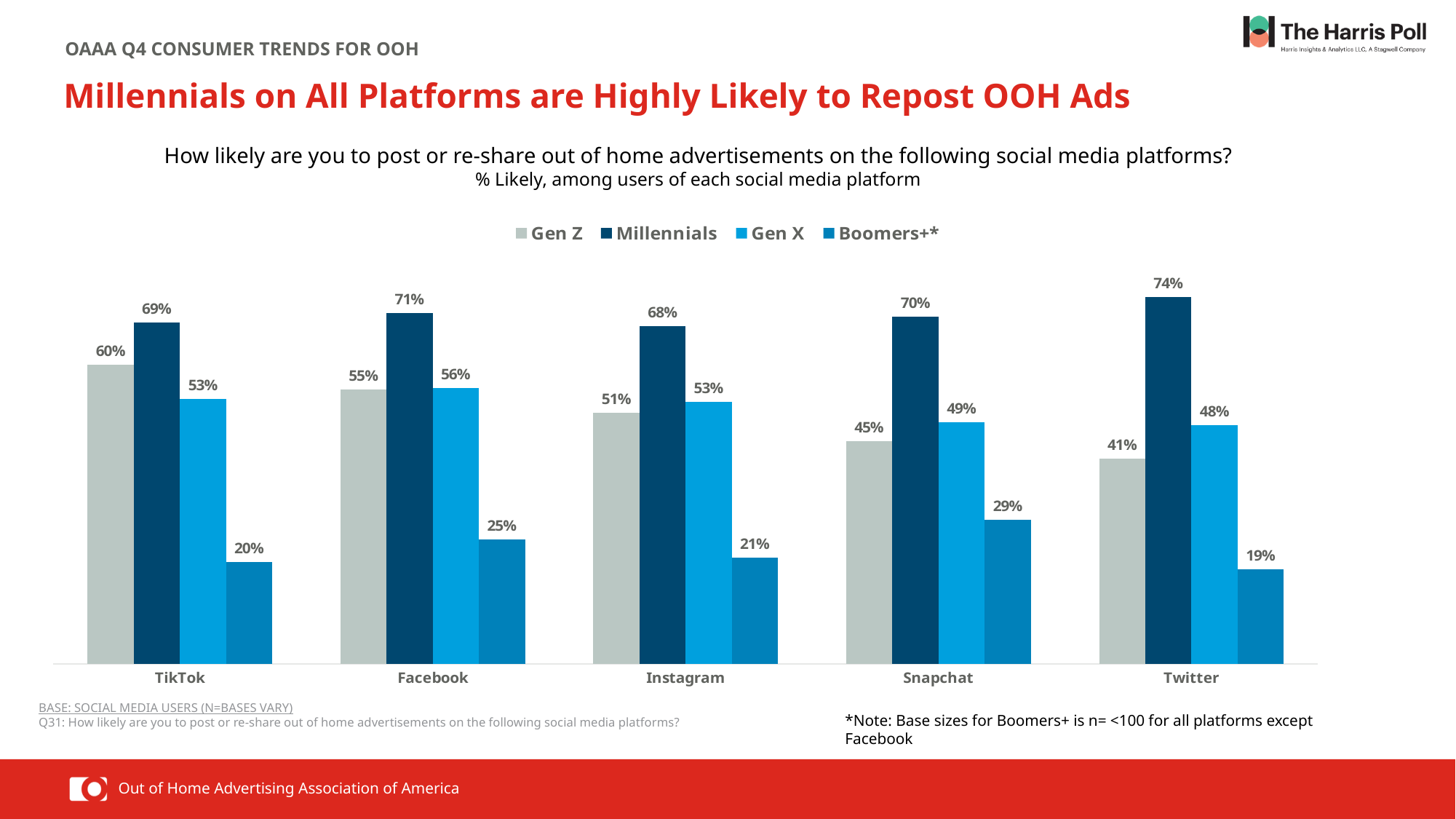
Which is larger for Facebook: the Gen Z value or the Gen X value? Gen X On which platform is the Millennials value highest? Twitter What is the Boomers+ value for Facebook? 25% How many series does the legend list? 4 What kind of chart is shown on the slide? Bar chart What percentage of Millennials are likely to post or re-share OOH ads on Twitter? 74% Which series is shown in the darkest blue colour? Millennials What is the Gen X value for Snapchat? 49% What is the difference between the Millennials and Gen Z values for Instagram? 17 percentage points What is the Gen Z value for TikTok? 60% How many social media platforms are shown on the x axis? 5 On which platform is the Boomers+ value lowest? Twitter